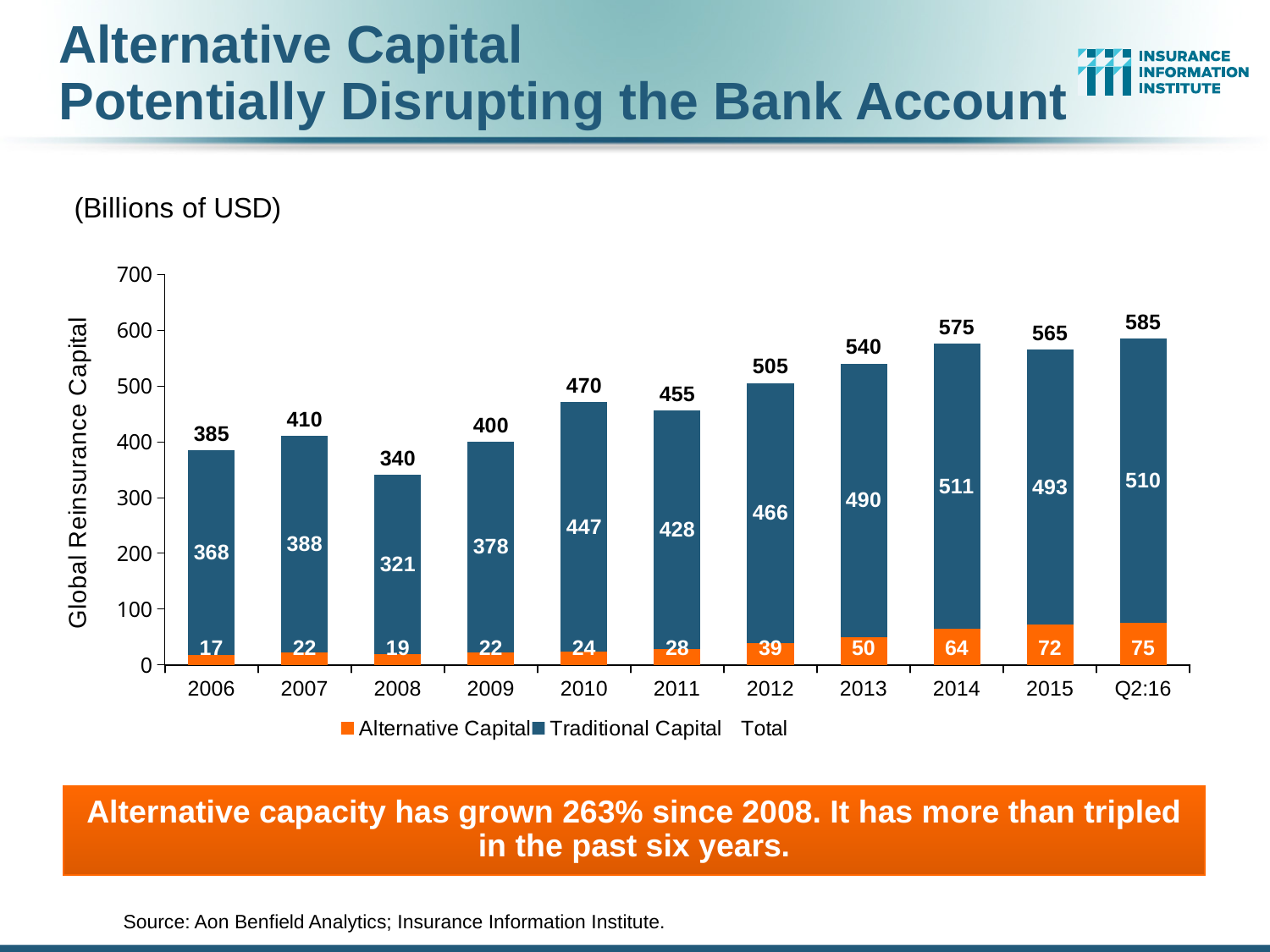
What is the difference between the Total for Q2:16 and the Total for 2006? 200 Which year has the lowest Total global reinsurance capital? 2008 What kind of chart is shown on the slide? Stacked bar chart What is the Total value shown for 2008? 340 What is the y-axis label of the chart? Global Reinsurance Capital What is the Traditional Capital value for 2014? 511 Which category has the highest Alternative Capital value? Q2:16 Is the Total for 2013 greater or less than 500? greater How many categories are shown on the x axis? 11 Which is larger, the Traditional Capital value for 2010 or for 2011? 2010 How many entries does the legend list? 3 What is the Alternative Capital value for 2012? 39